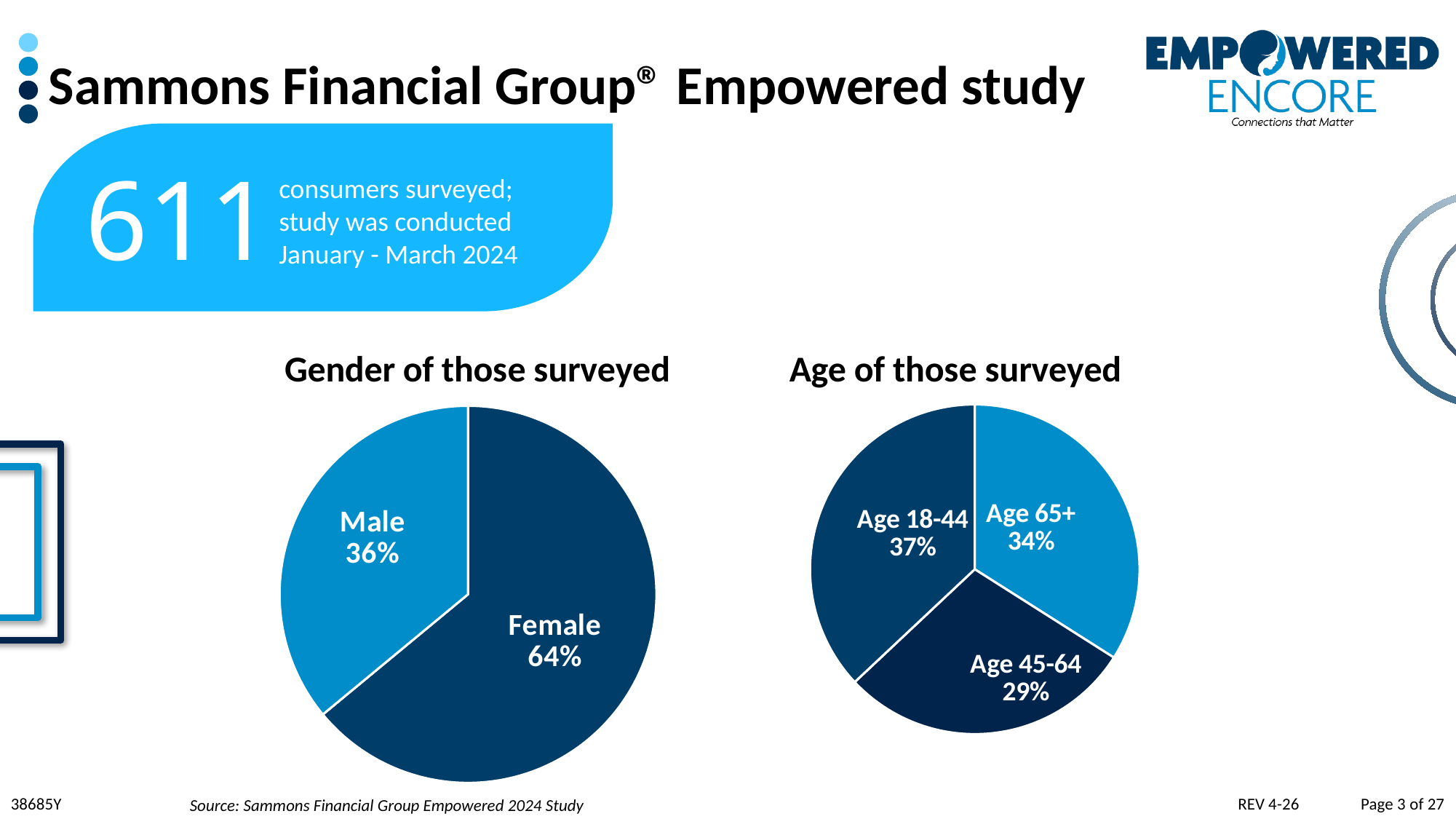
What kind of chart is the 'Gender of those surveyed' chart? Pie chart In the 'Gender of those surveyed' chart, what is the difference in percentage points between the female and male shares? 28 In the 'Age of those surveyed' chart, which age group has the smallest share? Age 45-64 In the 'Age of those surveyed' chart, what share of those surveyed were Age 45-64? 29% In the 'Gender of those surveyed' chart, what share of those surveyed were male? 36% In the 'Age of those surveyed' chart, what share of those surveyed were Age 18-44? 37% In the 'Age of those surveyed' chart, which is larger, the share for Age 65+ or the share for Age 45-64? Age 65+ How many slices does the 'Age of those surveyed' chart have? 3 In the 'Age of those surveyed' chart, what share of those surveyed were Age 65+? 34% What is the title of the chart on the right side of the slide? Age of those surveyed In the 'Gender of those surveyed' chart, what share of those surveyed were female? 64% In the 'Age of those surveyed' chart, which age group has the largest share? Age 18-44